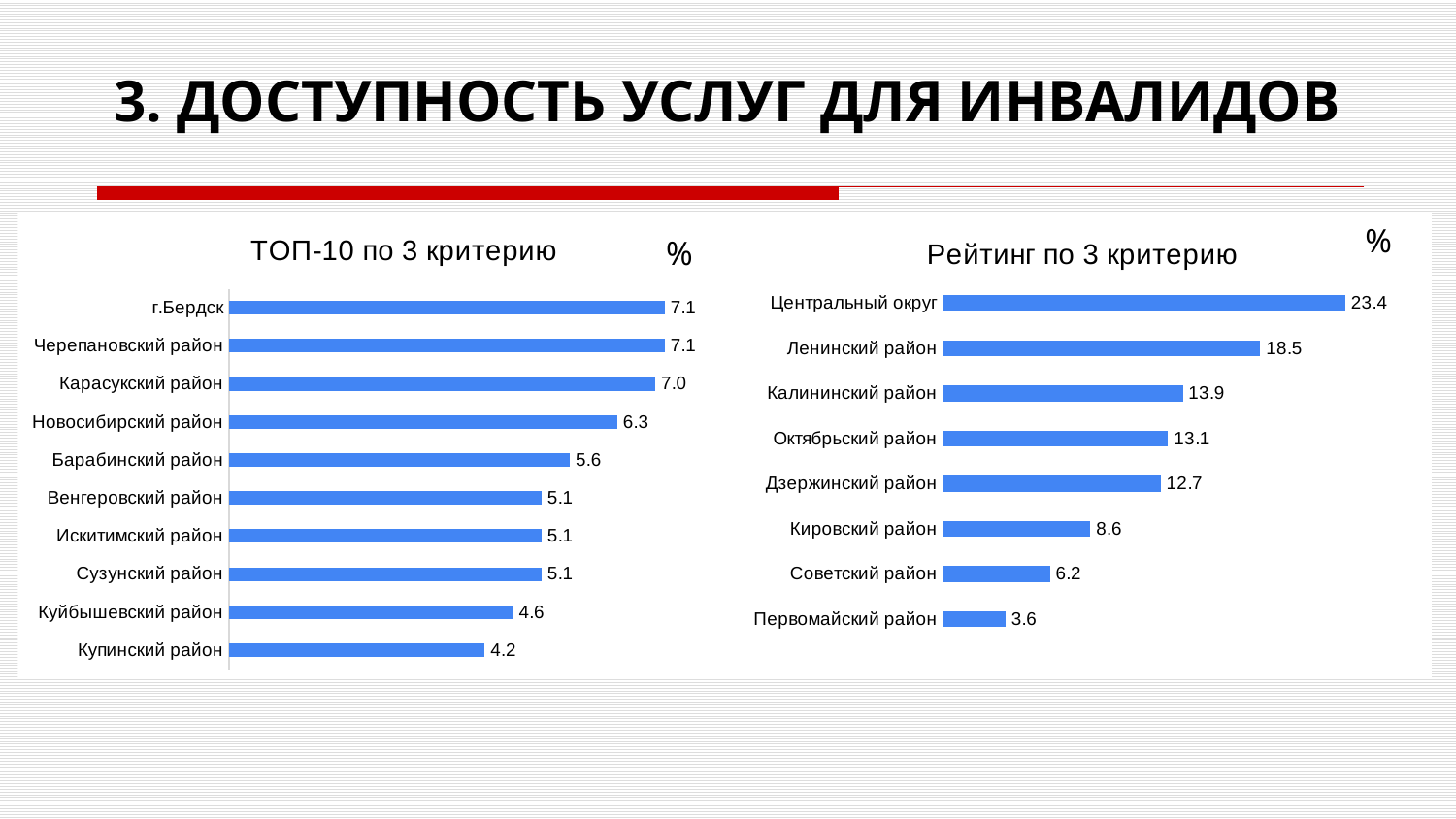
In the chart titled 'ТОП-10 по 3 критерию', which category has the lowest value? Купинский район In the chart titled 'ТОП-10 по 3 критерию', what is the difference between the values for Барабинский район and Купинский район? 1.4 In the chart titled 'Рейтинг по 3 критерию', which is larger: the value for Калининский район or Дзержинский район? Калининский район In the chart titled 'Рейтинг по 3 критерию', which category has the highest value? Центральный округ In the chart titled 'Рейтинг по 3 критерию', what is the value for Кировский район? 8.6 In the chart titled 'ТОП-10 по 3 критерию', which is larger: the value for Карасукский район or Куйбышевский район? Карасукский район In the chart titled 'Рейтинг по 3 критерию', what is the difference between the values for Центральный округ and Ленинский район? 4.9 In the chart titled 'ТОП-10 по 3 критерию', what is the value for Новосибирский район? 6.3 How many categories are shown in the chart titled 'ТОП-10 по 3 критерию'? 10 How many categories are shown in the chart titled 'Рейтинг по 3 критерию'? 8 What type of chart is the chart titled 'Рейтинг по 3 критерию'? Bar chart In the chart titled 'Рейтинг по 3 критерию', which category has the lowest value? Первомайский район